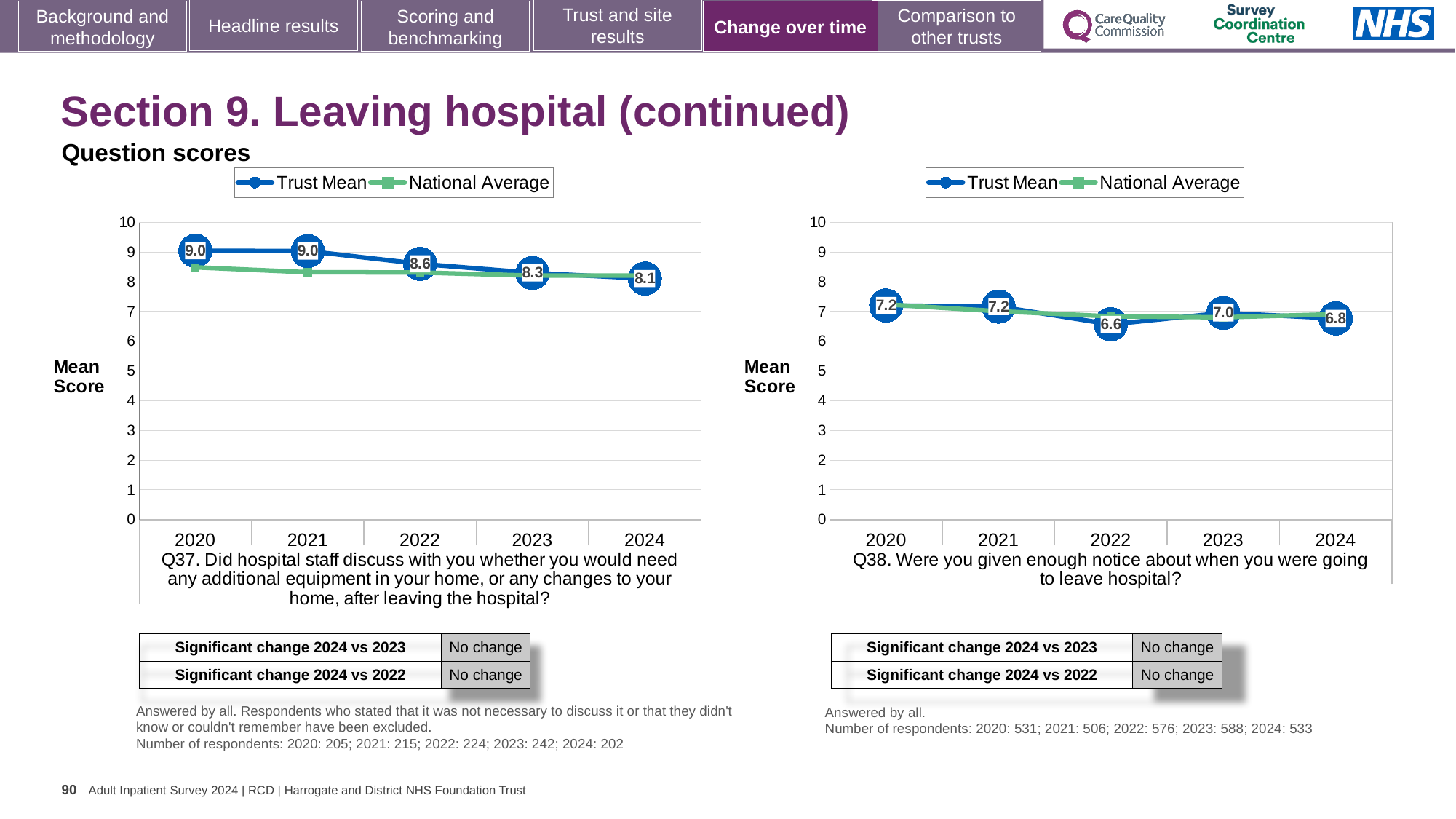
What kind of chart is the Q37 chart (left)? line chart On the Q38 chart (right), what is the Trust Mean score for 2022? 6.6 On the Q37 chart (left), what is the difference between the Trust Mean in 2020 and in 2024? 0.9 On the Q37 chart (left), what is the Trust Mean score for 2020? 9.0 On the Q37 chart (left), does the Trust Mean generally rise or fall from 2020 to 2024? fall On the Q38 chart (right), which is larger, the Trust Mean for 2021 or for 2022? 2021 On the Q37 chart (left), what is the Trust Mean score for 2024? 8.1 On the Q38 chart (right), what is the Trust Mean score for 2023? 7.0 On the Q37 chart (left), in which year is the Trust Mean lowest? 2024 On the Q38 chart (right), in which year is the Trust Mean lowest? 2022 On the Q37 chart (left), is the National Average value for 2020 greater or less than 8? greater How many years are shown on the x axis of the Q38 chart (right)? 5